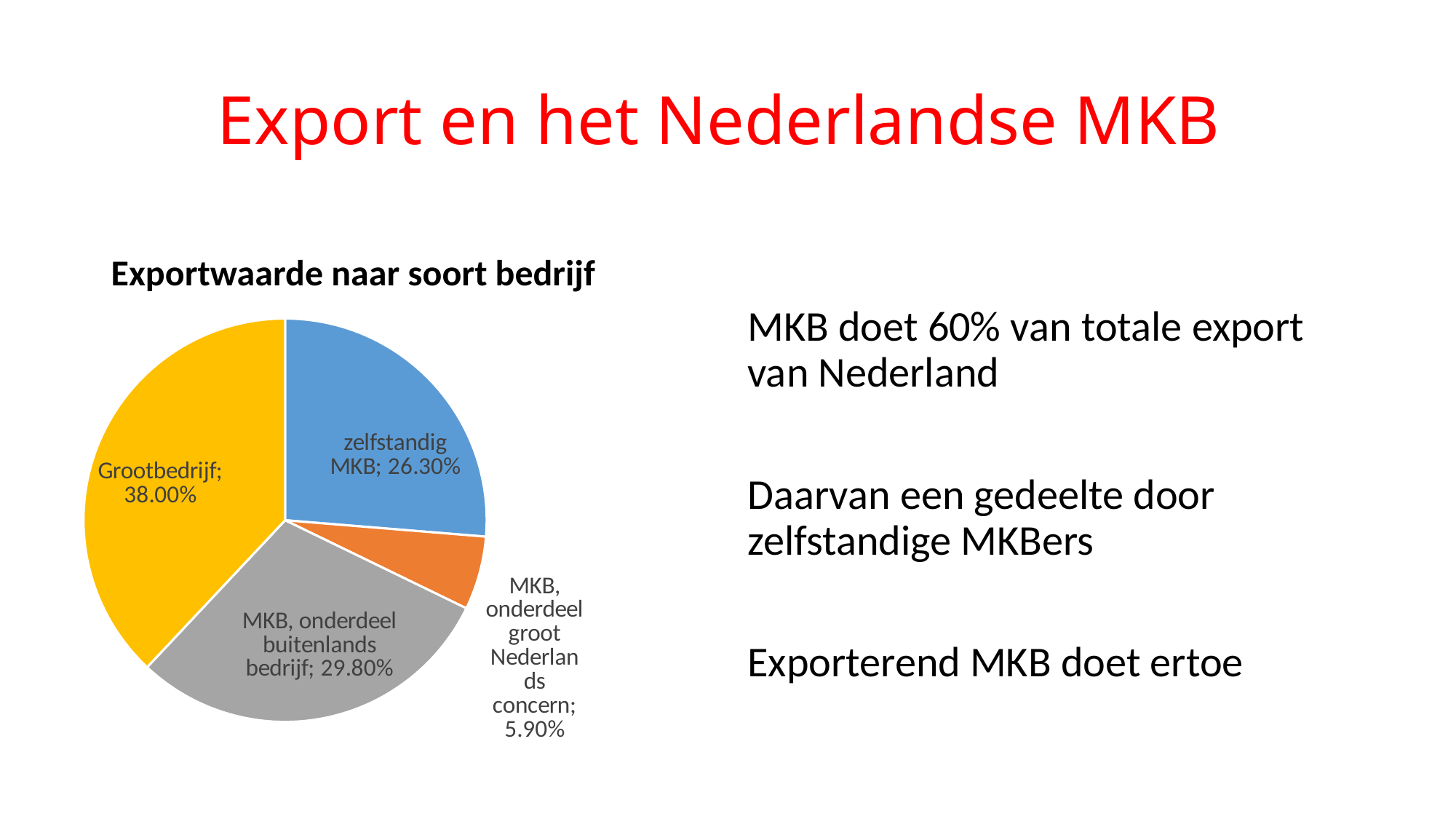
Which category has the largest share of the pie? Grootbedrijf What type of chart is shown on the slide? Pie chart What is the title of the chart? Exportwaarde naar soort bedrijf What is the value for zelfstandig MKB? 26.30% What is the value for MKB, onderdeel buitenlands bedrijf? 29.80% What is the value for Grootbedrijf? 38.00% What is the difference between the Grootbedrijf share and the zelfstandig MKB share? 11.70% How many slices does the pie chart have? 4 What is the value for MKB, onderdeel groot Nederlands concern? 5.90% Which is larger: the share for MKB, onderdeel buitenlands bedrijf or the share for zelfstandig MKB? MKB, onderdeel buitenlands bedrijf Which category has the smallest share of the pie? MKB, onderdeel groot Nederlands concern What colour is the Grootbedrijf slice? Yellow